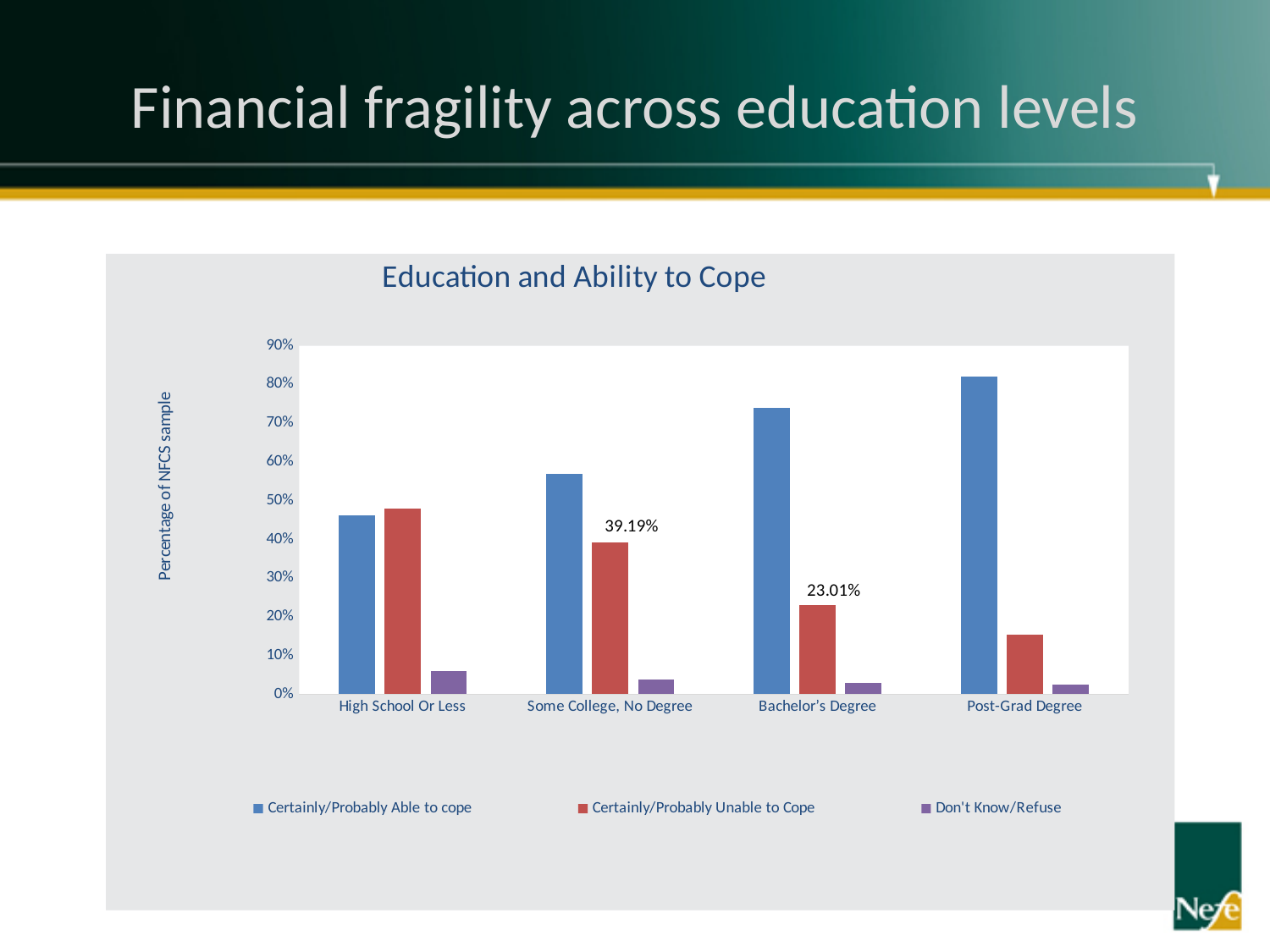
For Some College, No Degree, which is larger: Certainly/Probably Able to cope or Certainly/Probably Unable to Cope? Certainly/Probably Able to cope Which education level has the lowest value for Certainly/Probably Unable to Cope? Post-Grad Degree What is the value for Certainly/Probably Unable to Cope for Some College, No Degree? 39.19% Is the value for Certainly/Probably Able to cope for High School Or Less greater or less than 50%? less What is the value for Certainly/Probably Unable to Cope for Bachelor's Degree? 23.01% Does the value for Certainly/Probably Able to cope rise or fall as education level increases from High School Or Less to Post-Grad Degree? Rise How many education levels are shown on the x axis? 4 What kind of chart is shown on the slide? Bar chart How many series does the legend list? 3 Which education level has the highest value for Certainly/Probably Able to cope? Post-Grad Degree Is the value for Certainly/Probably Able to cope for Post-Grad Degree greater or less than 70%? greater What is the difference between the Certainly/Probably Unable to Cope values for Some College, No Degree and Bachelor's Degree? 16.18%